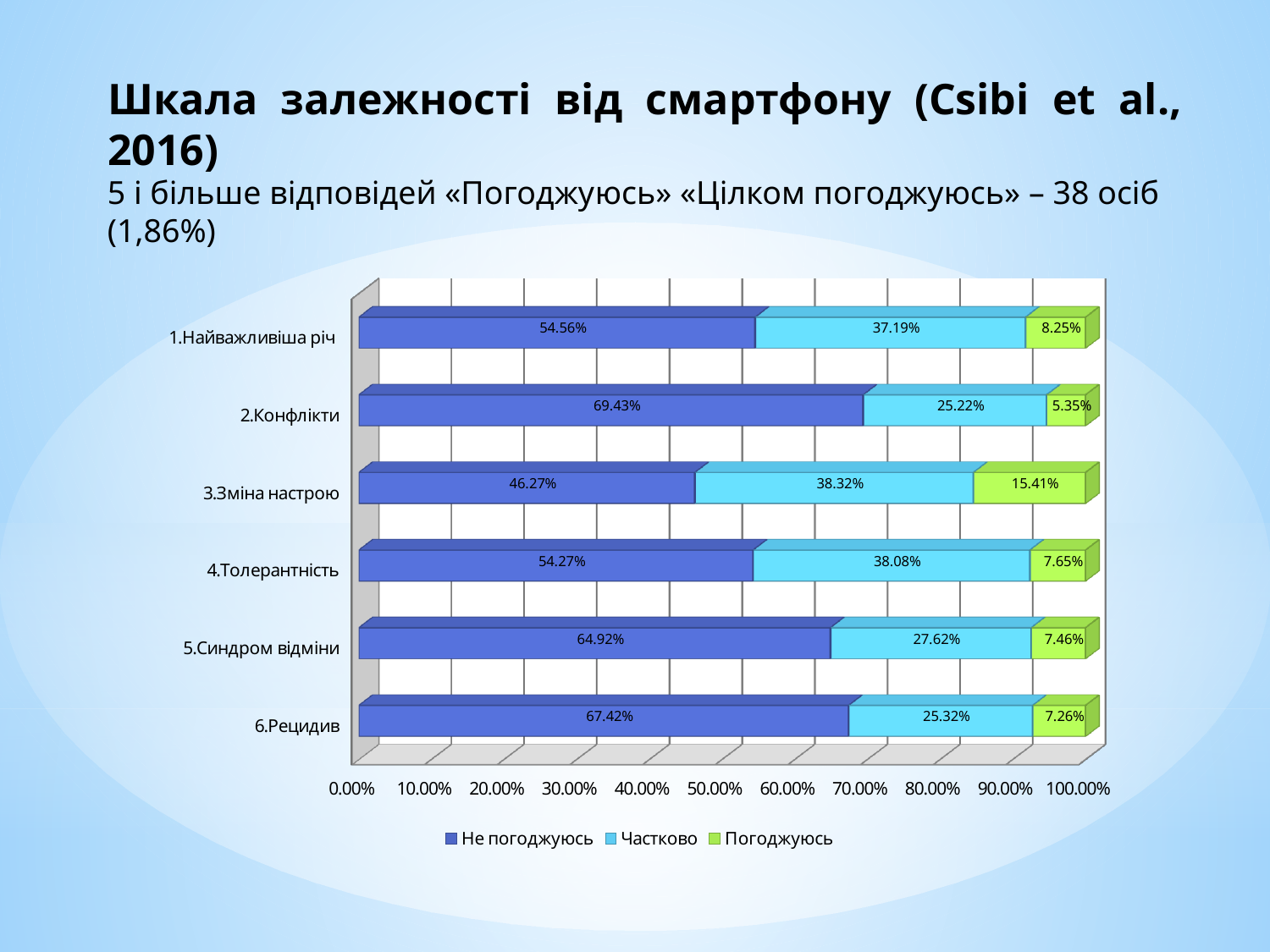
Is the «Не погоджуюсь» value for «6.Рецидив» greater or less than 60.00%? greater How many series does the legend list? 3 Which category has the highest «Не погоджуюсь» value? 2.Конфлікти How many categories are plotted on the chart? 6 Which category has the lowest «Погоджуюсь» value? 2.Конфлікти What is the value of «Не погоджуюсь» for «2.Конфлікти»? 69.43% What is the total of the stacked bar for «4.Толерантність»? 100.00% What is the value of «Погоджуюсь» for «6.Рецидив»? 7.26% Which is larger: the «Частково» value for «1.Найважливіша річ» or for «5.Синдром відміни»? 1.Найважливіша річ What type of chart is shown on the slide? Stacked bar chart What is the difference between the «Не погоджуюсь» values for «2.Конфлікти» and «3.Зміна настрою»? 23.16% What is the value of «Частково» for «3.Зміна настрою»? 38.32%